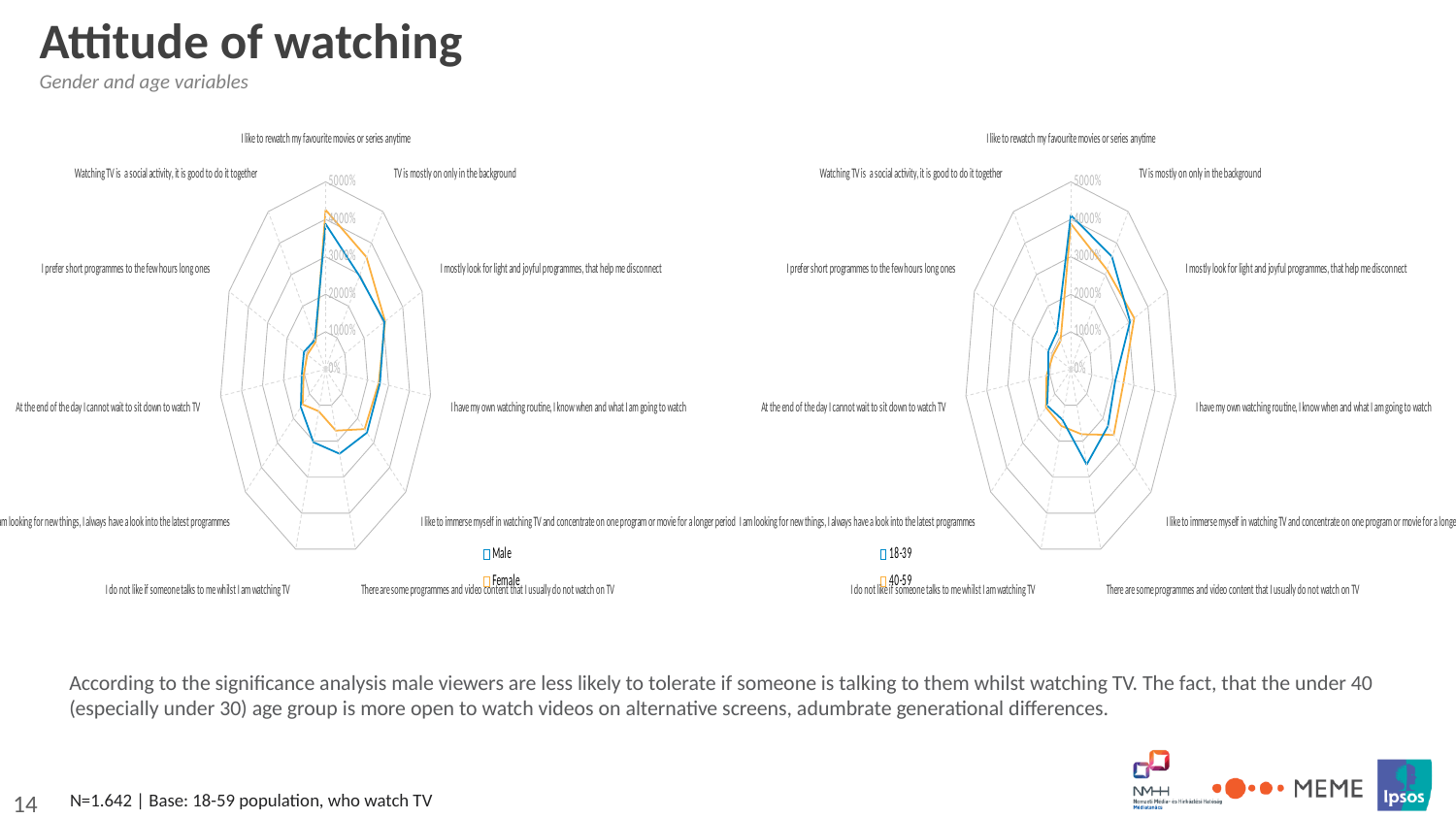
In the right chart, which series has the larger value for 'I do not like if someone talks to me whilst I am watching TV', 18-39 or 40-59? 40-59 What are the two series named in the legend of the right chart? 18-39 and 40-59 What kind of chart is shown on the left side of the slide? Radar chart How many statements (categories) are plotted on the left chart? 11 How many statements (categories) are plotted on the right chart? 11 In the left chart, is the Male value for 'At the end of the day I cannot wait to sit down to watch TV' greater or less than 2000%? less How many series does the legend of the right chart list? 2 What kind of chart is shown on the right side of the slide? Radar chart How many series does the legend of the left chart list? 2 In the left chart, which series has the larger value for 'I do not like if someone talks to me whilst I am watching TV', Male or Female? Male In the left chart, is the Male value for 'I prefer short programmes to the few hours long ones' greater or less than 3000%? less What are the two series named in the legend of the left chart? Male and Female